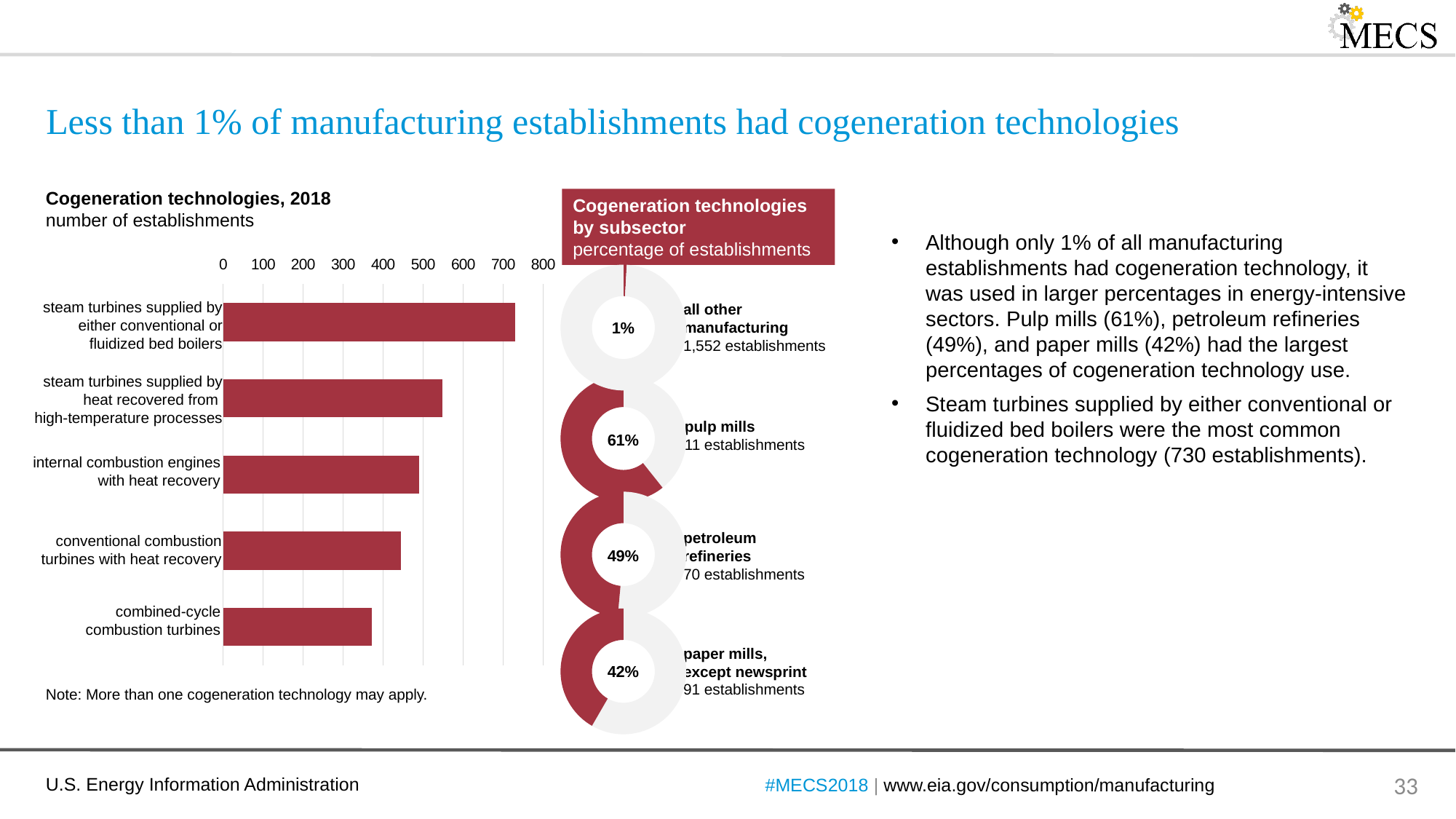
What kind of chart is the 'Cogeneration technologies, 2018' chart on the left? bar chart In the 'Cogeneration technologies by subsector' donut charts, what percentage of pulp mills establishments had cogeneration technologies? 61% In the 'Cogeneration technologies by subsector' donut charts, what percentage is shown for petroleum refineries? 49% In the 'Cogeneration technologies, 2018' bar chart, which has more establishments: steam turbines supplied by heat recovered from high-temperature processes or internal combustion engines with heat recovery? steam turbines supplied by heat recovered from high-temperature processes In the 'Cogeneration technologies by subsector' donut charts, which subsector has the lowest percentage of establishments with cogeneration technologies? all other manufacturing In the 'Cogeneration technologies by subsector' donut charts, what is the difference in percentage points between pulp mills and paper mills, except newsprint? 19 percentage points In the 'Cogeneration technologies, 2018' bar chart, is the value for combined-cycle combustion turbines greater or less than 400? less In the 'Cogeneration technologies, 2018' bar chart, how many cogeneration technologies are plotted? 5 In the 'Cogeneration technologies, 2018' bar chart, is the value for steam turbines supplied by heat recovered from high-temperature processes greater or less than 500? greater In the 'Cogeneration technologies, 2018' bar chart, which technology has the highest number of establishments? steam turbines supplied by either conventional or fluidized bed boilers In the 'Cogeneration technologies, 2018' bar chart, which technology has the lowest number of establishments? combined-cycle combustion turbines In the 'Cogeneration technologies, 2018' bar chart, is the value for conventional combustion turbines with heat recovery greater or less than 400? greater